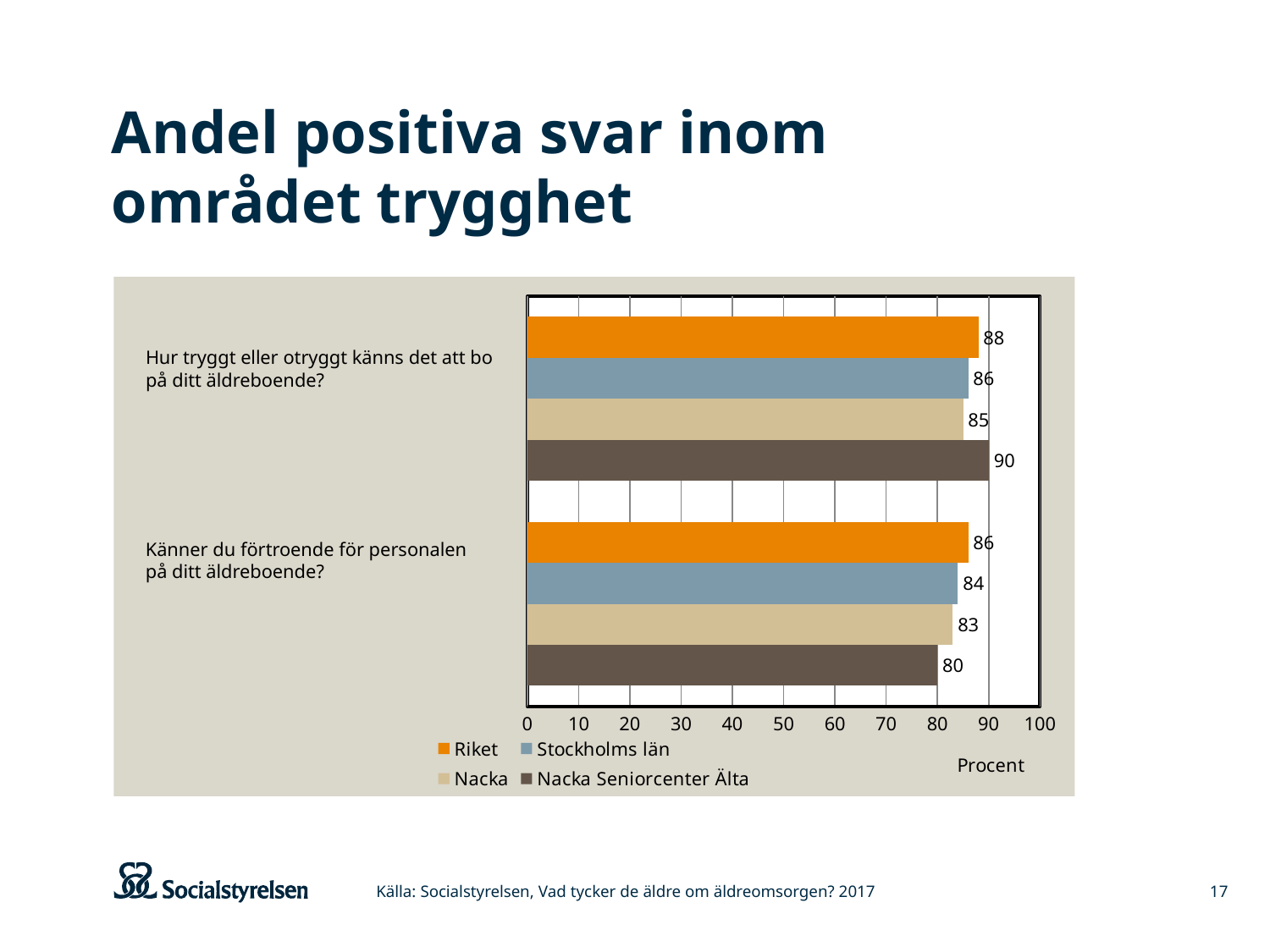
What is the value for Stockholms län on the question "Känner du förtroende för personalen på ditt äldreboende?"? 84 What is the difference between the Riket and Nacka Seniorcenter Älta values for "Känner du förtroende för personalen på ditt äldreboende?"? 6 How many series does the legend list? 4 What is the value for Riket on the question "Hur tryggt eller otryggt känns det att bo på ditt äldreboende?"? 88 What kind of chart is shown on the slide? Bar chart What is the value for Nacka Seniorcenter Älta on the question "Känner du förtroende för personalen på ditt äldreboende?"? 80 What is the difference between the Riket and Nacka values for "Hur tryggt eller otryggt känns det att bo på ditt äldreboende?"? 3 Which is larger: the Nacka value for "Hur tryggt eller otryggt känns det att bo på ditt äldreboende?" or the Nacka value for "Känner du förtroende för personalen på ditt äldreboende?"? Hur tryggt eller otryggt känns det att bo på ditt äldreboende? How many questions (categories) are shown on the chart? 2 Which series has the lowest value for "Känner du förtroende för personalen på ditt äldreboende?"? Nacka Seniorcenter Älta What unit is shown on the x axis of the chart? Procent Which series has the highest value for "Hur tryggt eller otryggt känns det att bo på ditt äldreboende?"? Nacka Seniorcenter Älta